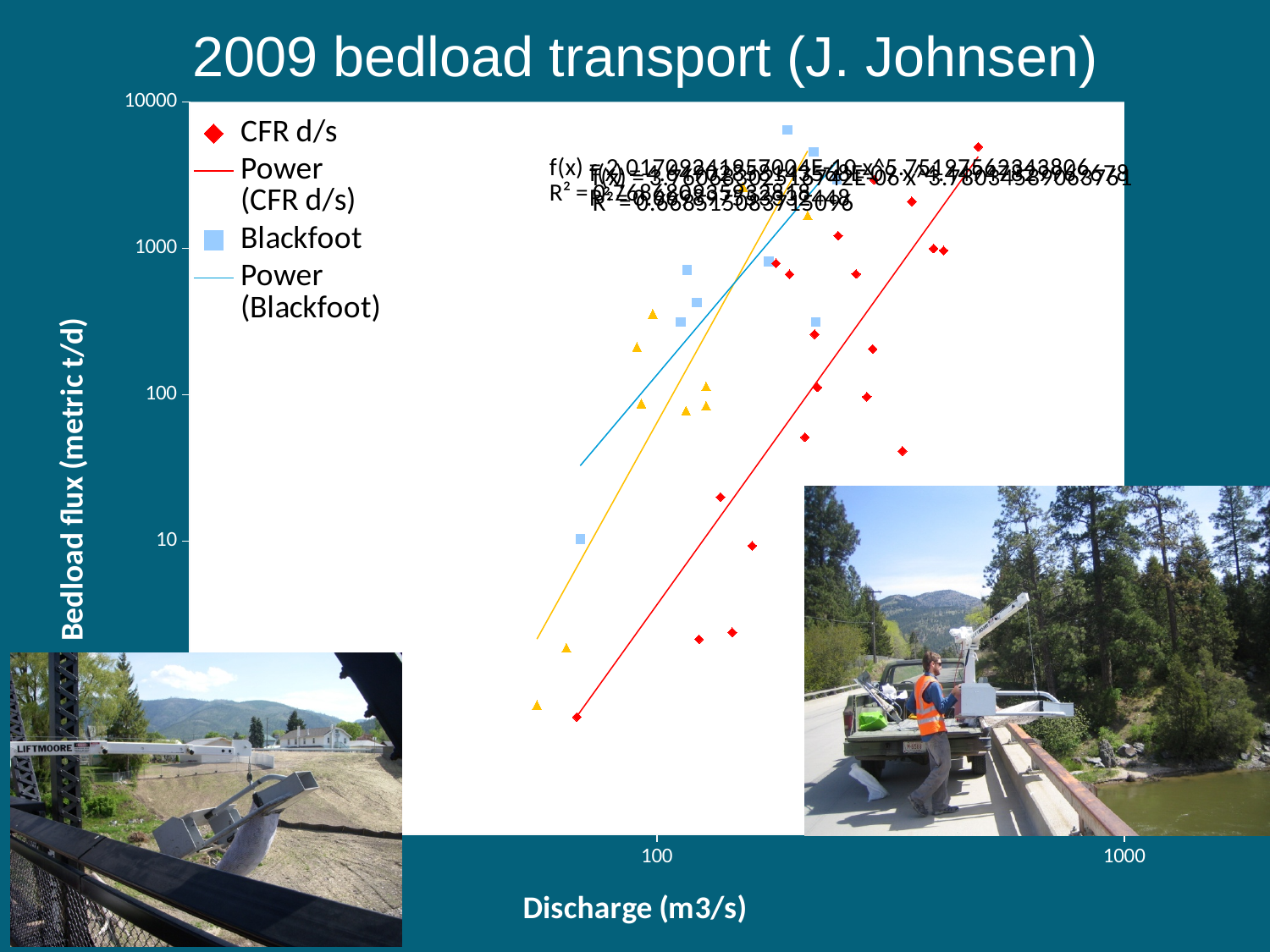
What kind of chart is shown on the slide? Scatter chart How many labelled tick values are shown on the vertical axis? 4 Is the highest Blackfoot point greater or less than 1000 metric t/d? greater Do the bedload flux values generally rise or fall as discharge increases along the x axis? Rise Is the lowest Blackfoot point greater or less than 100 metric t/d? less What is the title of the chart? 2009 bedload transport (J. Johnsen) Is the lowest CFR d/s point greater or less than 10 metric t/d? less How many entries does the chart's legend list? 4 How many labelled tick values are shown on the horizontal axis? 2 What is the label on the vertical axis of the chart? Bedload flux (metric t/d)